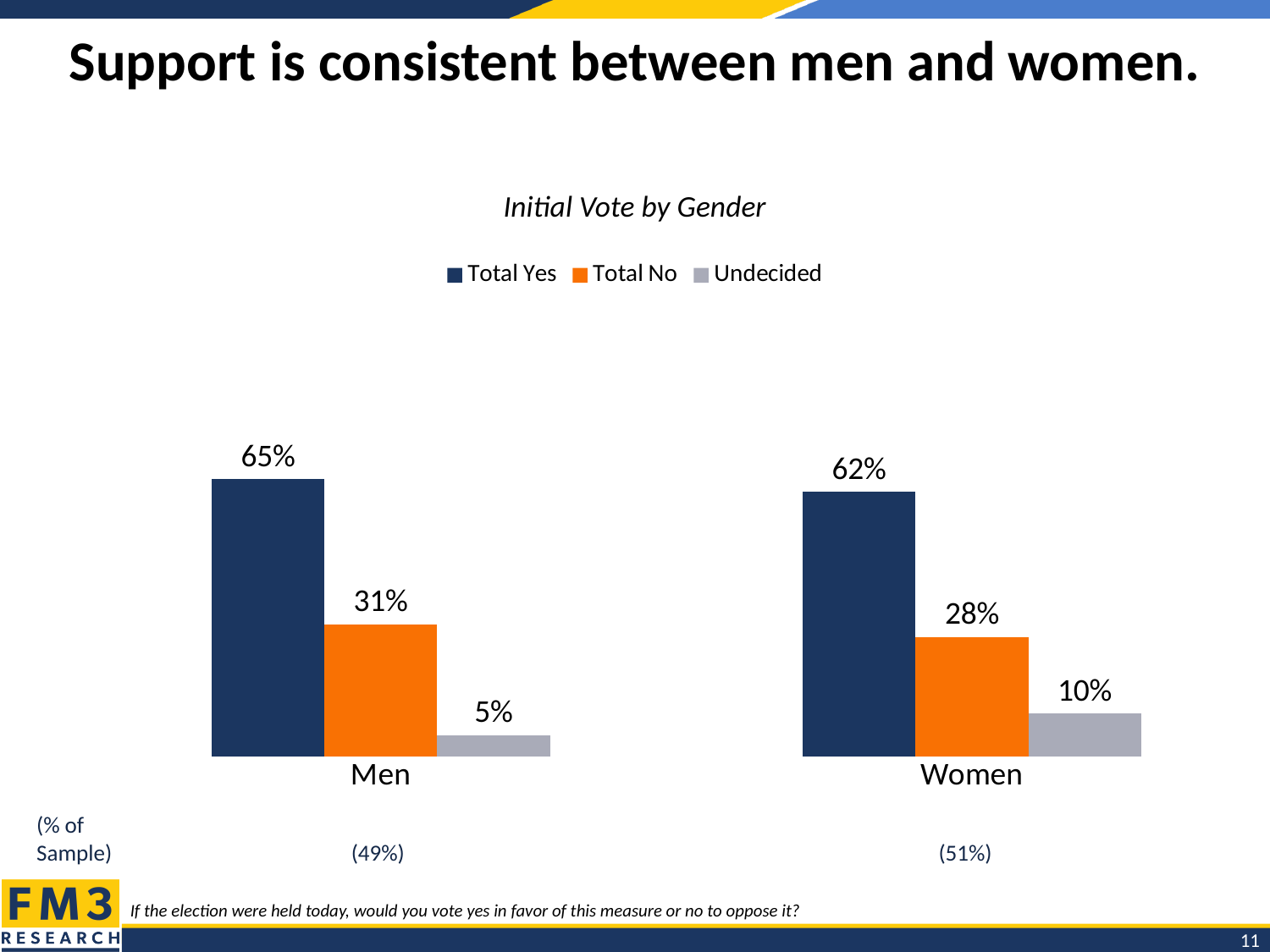
How many series does the legend list? 3 Which series has the lowest value for Women? Undecided Which gender has the higher Total Yes value? Men What kind of chart is shown on the slide? Bar chart What is the difference between the Total Yes values for Men and Women? 3% What is the title of the chart? Initial Vote by Gender How many categories are shown on the x axis? 2 What is the Total No value for Women? 28% What is the Total Yes value for Men? 65% What is the difference between Total Yes and Total No for Men? 34% What is the Undecided value for Women? 10% What is the Undecided value for Men? 5%